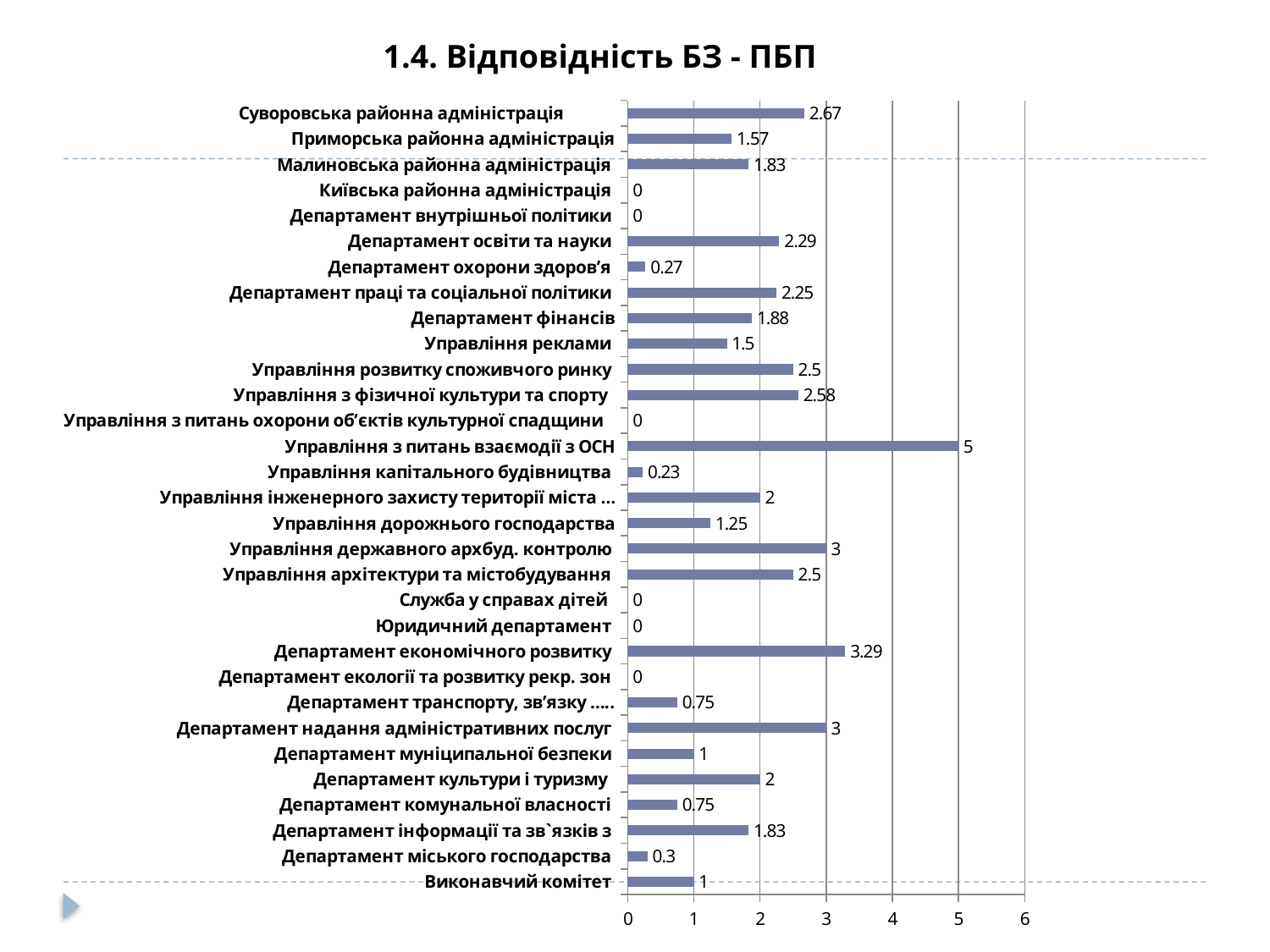
How many categories are shown on the chart? 31 What is the value for Суворовська районна адміністрація? 2.67 What is the value for Управління з питань взаємодії з ОСН? 5 What is the value for Департамент охорони здоров’я? 0.27 What is the value for Департамент економічного розвитку? 3.29 Which category has the highest value? Управління з питань взаємодії з ОСН What is the difference between the values for Управління з питань взаємодії з ОСН and Департамент економічного розвитку? 1.71 Is the value for Департамент освіти та науки greater or less than 2? greater What is the title of the chart? 1.4. Відповідність БЗ - ПБП How many categories have a value of 0? 6 What kind of chart is shown on the slide? Bar chart Which is larger, the value for Приморська районна адміністрація or Малиновська районна адміністрація? Малиновська районна адміністрація